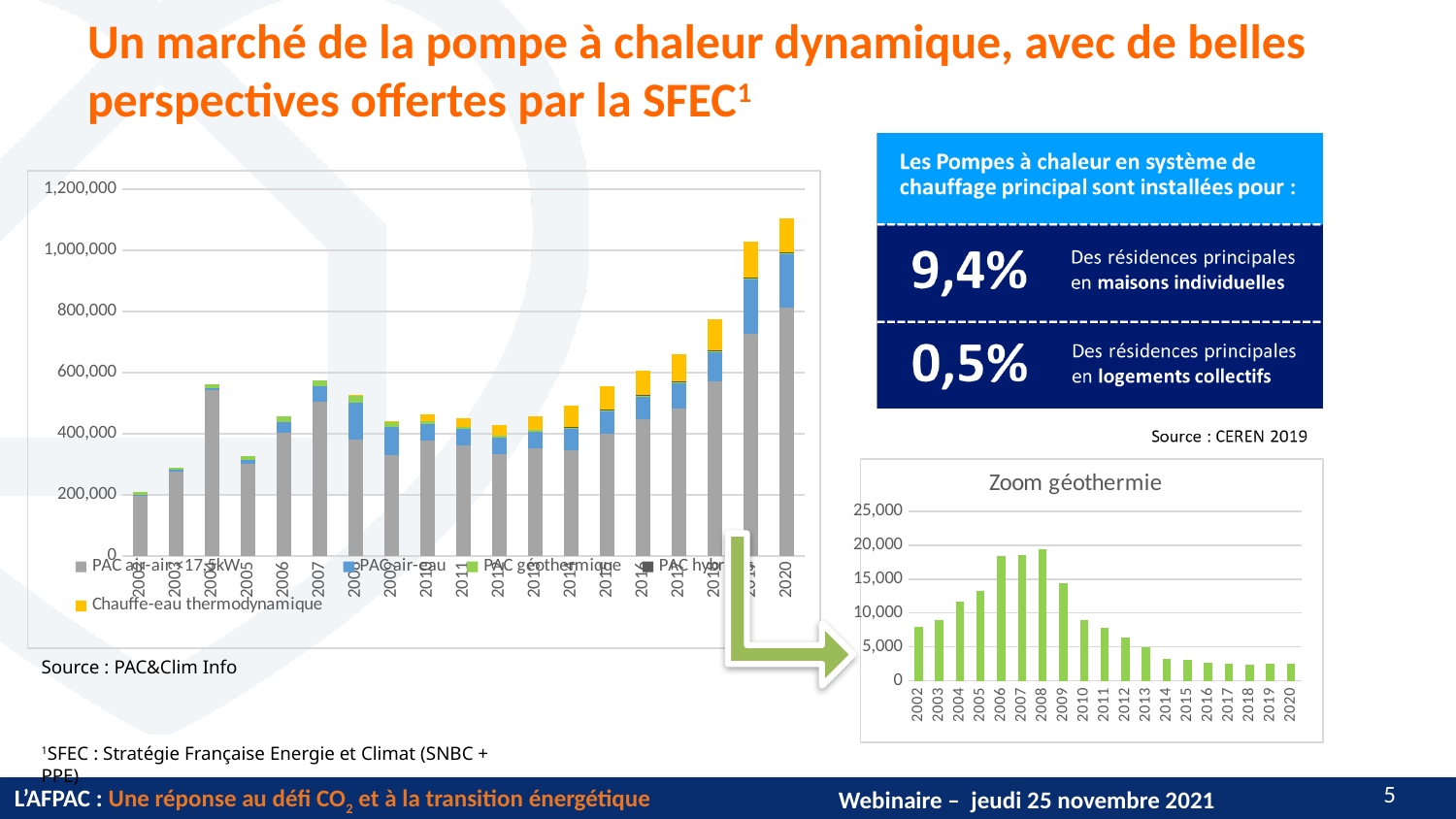
In the 'Zoom géothermie' chart, is the value for 2005 greater or less than 10,000? greater In the 'Zoom géothermie' chart, do the values rise or fall from 2008 to 2013? Fall In the 'Zoom géothermie' chart, is the value for 2008 greater or less than 15,000? greater In the 'Zoom géothermie' chart, how many years are shown on the x axis? 19 In the stacked bar chart on the left, is the total for 2002 greater or less than 400,000? less In the stacked bar chart on the left, which year has the larger total, 2019 or 2020? 2020 What kind of chart is the 'Zoom géothermie' chart on the right of the slide? Bar chart In the 'Zoom géothermie' chart, which year has the highest value? 2008 What is the title of the bar chart on the right of the slide? Zoom géothermie How many series does the legend of the stacked bar chart on the left list? 5